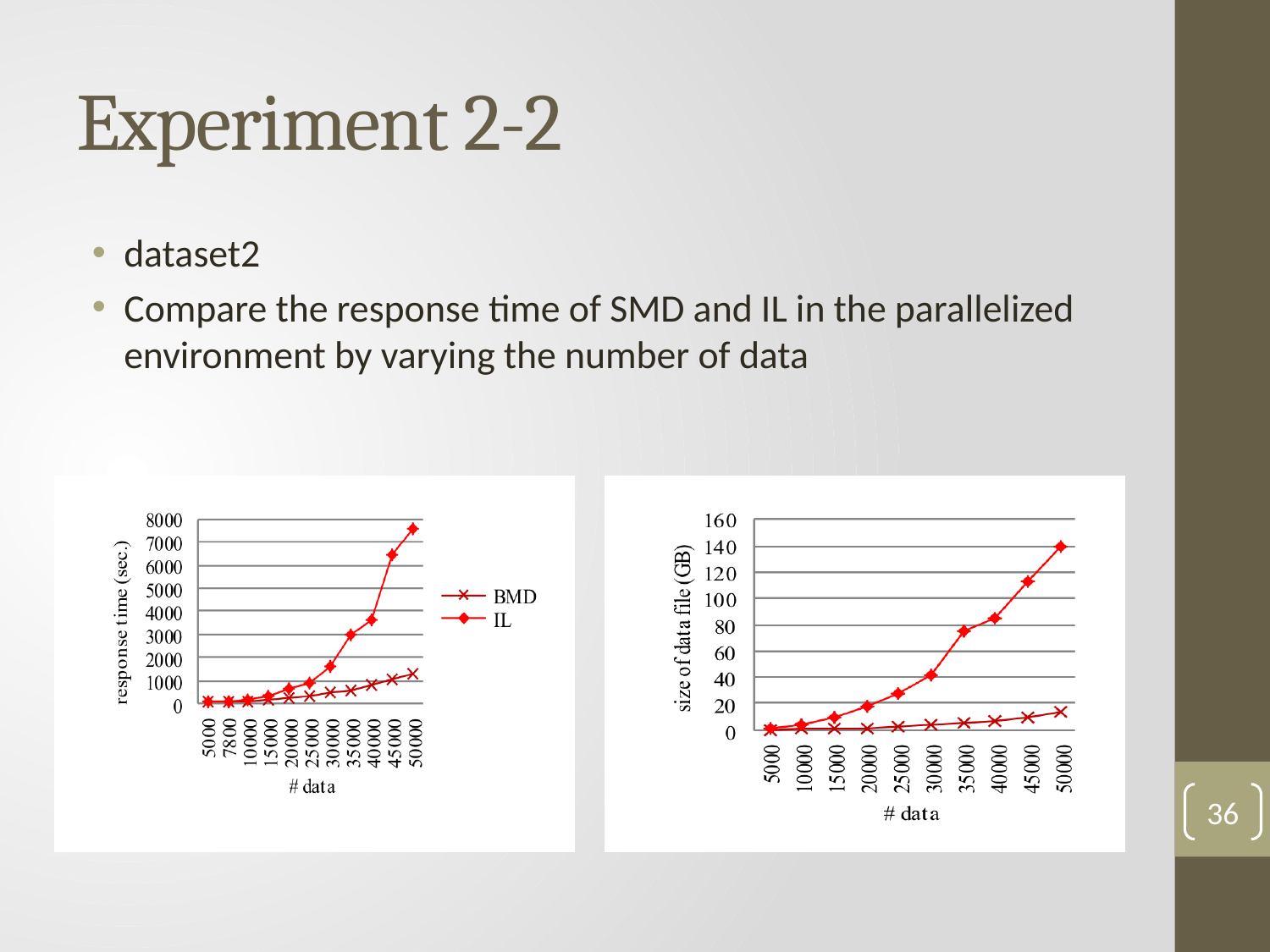
In the left chart (response time), how many # data values are shown on the x axis? 11 In the right chart (size of data file), is the value of the upper line (diamond markers) at 45000 greater or less than 100? greater What kind of chart is the left chart (response time)? line chart In the left chart (response time), is the IL value at 45000 greater or less than 6000? greater In the left chart (response time), is the BMD value at 50000 greater or less than 1000? greater In the left chart (response time), does the IL response time rise or fall as # data increases? rise In the left chart (response time), which series has the larger value at 50000, BMD or IL? IL What is the y-axis label of the right chart? size of data file (GB) How many series does the legend of the left chart (response time) list? 2 In the left chart (response time), at which # data value does IL reach its highest response time? 50000 In the right chart (size of data file), how many # data values are shown on the x axis? 10